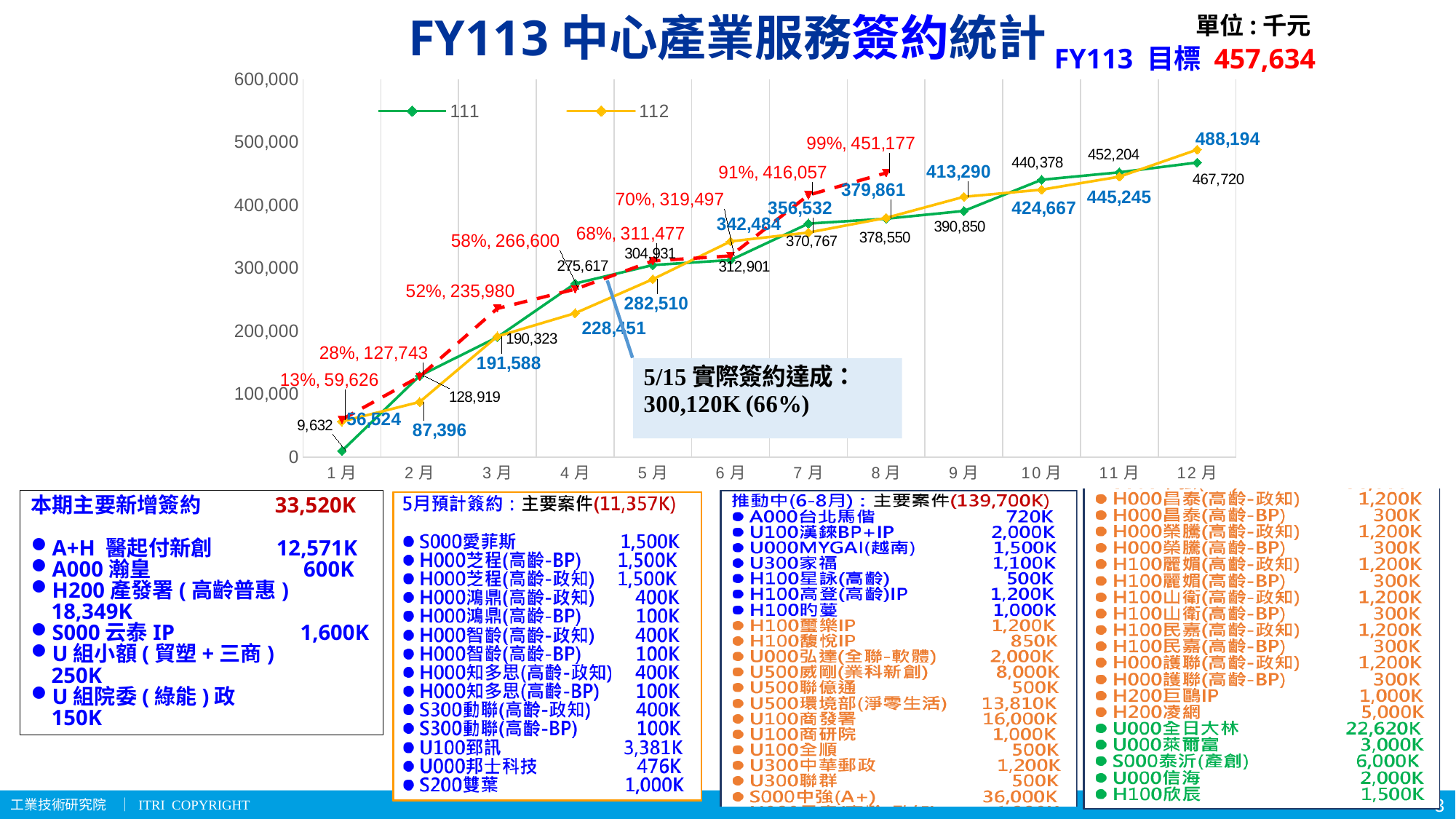
At 2月, which series has the larger value, 111 or 112? 111 What is the difference between series 112 and series 111 at 12月? 20,474 What is the value of series 111 at 12月? 467,720 What is the value of series 112 at 5月? 282,510 What is the value of series 111 at 1月? 9,632 What kind of chart is shown on the slide? line chart What FY113 target value is shown at the top right of the chart? 457,634 What is the value of series 112 at 12月? 488,194 In which month does series 111 reach its lowest value? 1月 How many months are shown along the x axis of the chart? 12 How many series does the chart legend list? 2 Do the values of series 112 generally rise or fall from 1月 to 12月? rise